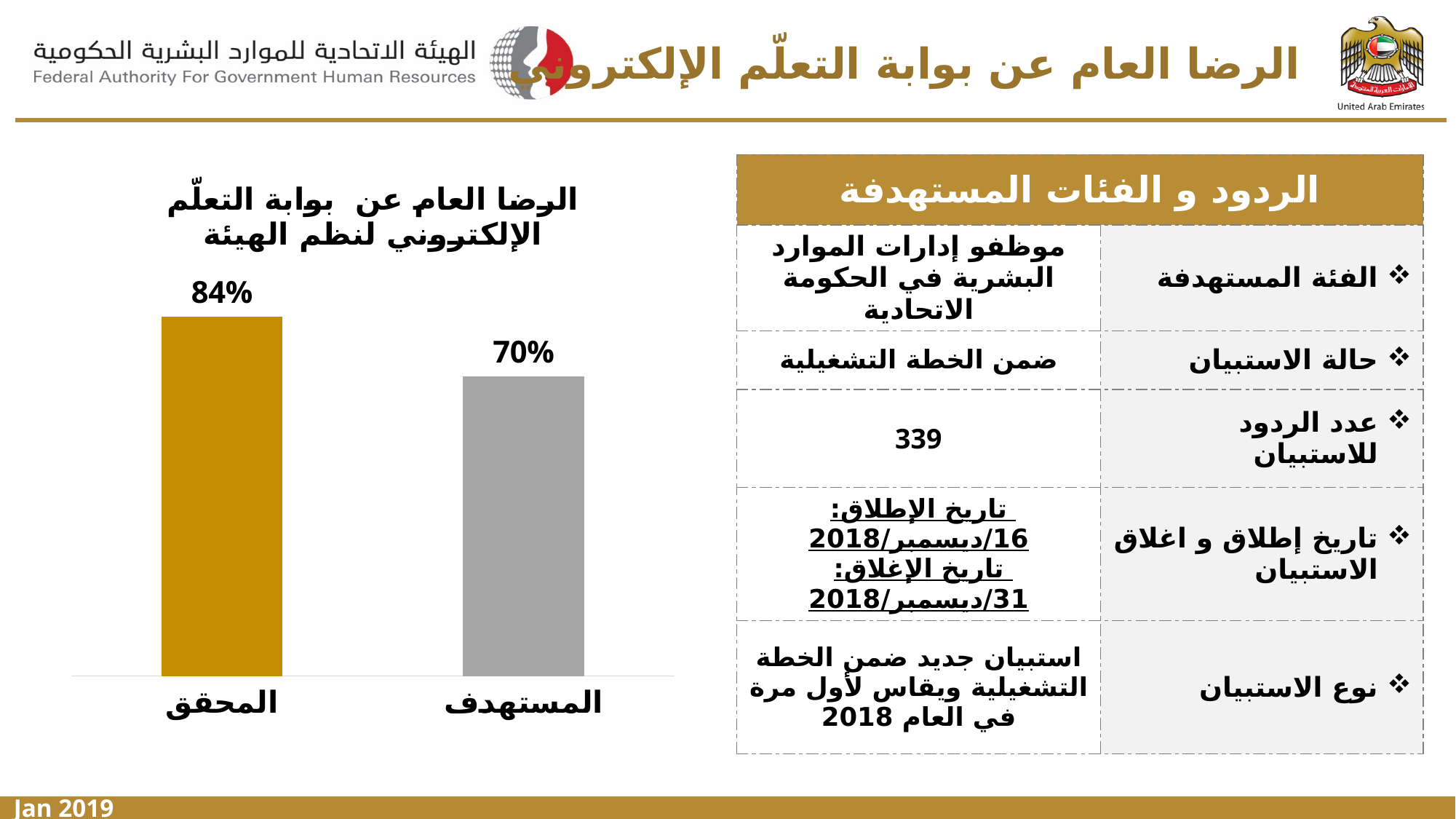
Which is larger, the value for المحقق or the value for المستهدف? المحقق How many bars are shown in the chart? 2 What kind of chart is shown on the slide? bar chart What is the title of the chart? الرضا العام عن بوابة التعلّم الإلكتروني لنظم الهيئة Which category has the lowest value in the bar chart? المستهدف What is the value for المحقق in the bar chart? 84% Which category has the highest value in the bar chart? المحقق What is the difference between the values for المحقق and المستهدف? 14% What colour is the bar for المحقق? gold What is the value for المستهدف in the bar chart? 70%